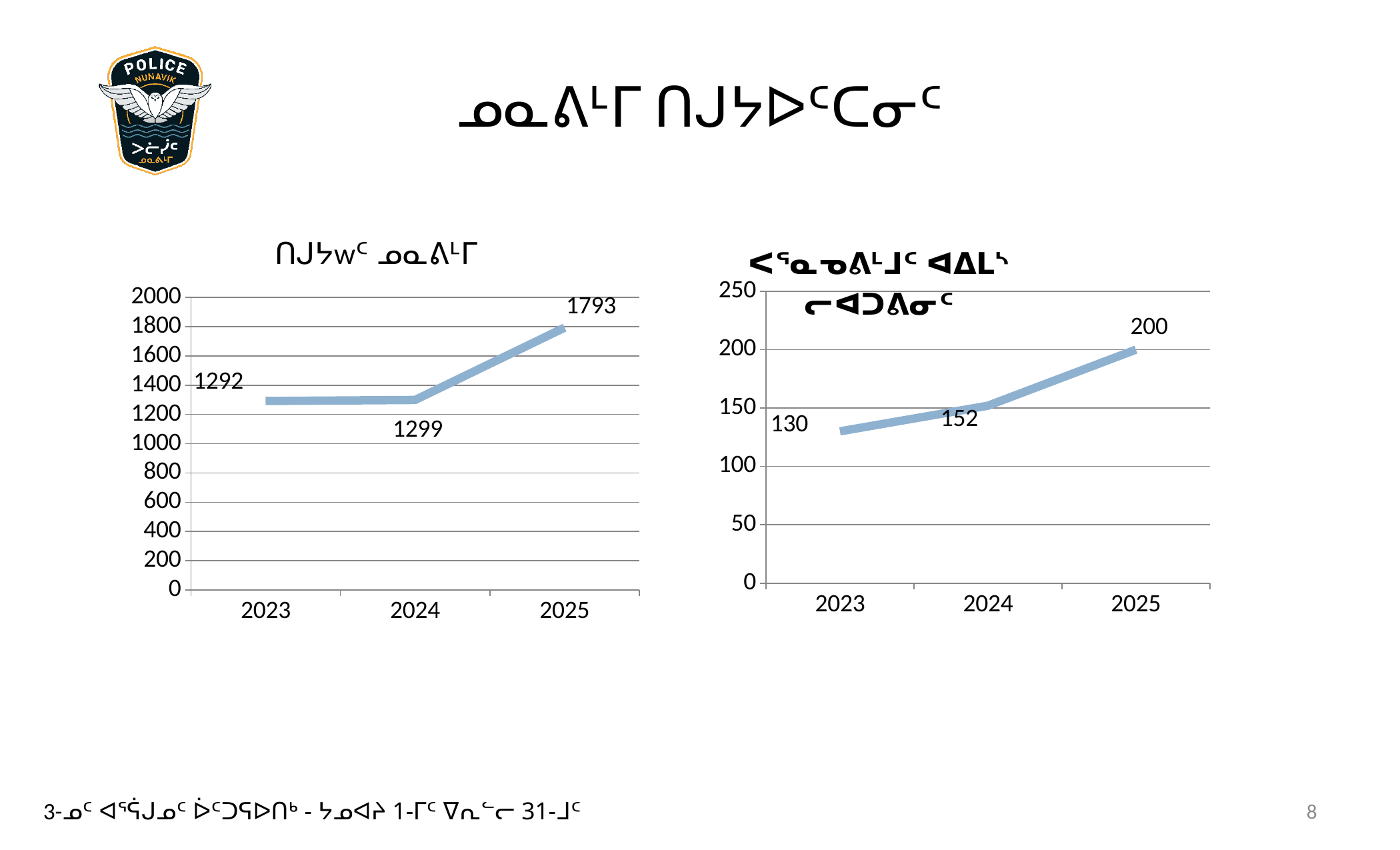
In the left chart, what is the value for 2025? 1793 In the left chart, what is the difference between the 2025 value and the 2024 value? 494 In the right chart, what is the value for 2023? 130 How many data points are plotted in the right chart? 3 In the left chart, what is the value for 2023? 1292 In the right chart, which year has the lowest value? 2023 In the right chart, is the value for 2024 larger or smaller than the value for 2025? smaller In the left chart, which year has the highest value? 2025 What kind of chart is the left chart? line chart In the right chart, what is the difference between the 2025 value and the 2023 value? 70 In the right chart, do the values rise or fall from 2023 to 2025? rise In the right chart, what is the value for 2024? 152